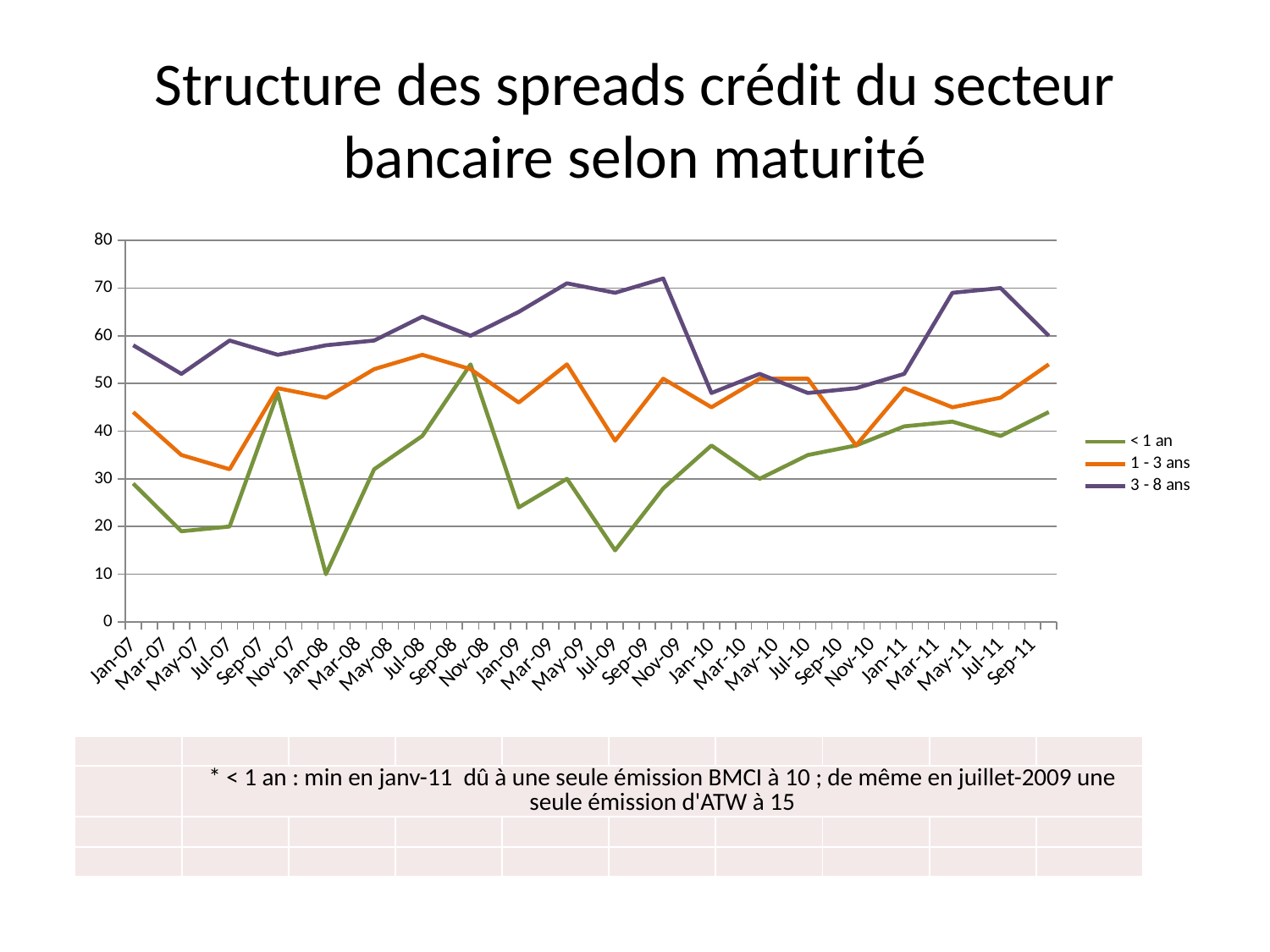
Is the value for "3 - 8 ans" at Nov-09 greater or less than 60? greater What colour is the line for the "< 1 an" series? green At Jan-07, which series has the larger value, "3 - 8 ans" or "< 1 an"? 3 - 8 ans At which date does the "< 1 an" series reach its lowest value? Jan-08 Is the value for "3 - 8 ans" at Jan-07 greater or less than 50? greater How many series does the legend list? 3 Is the value for "< 1 an" at Jul-09 greater or less than 20? less Which series has the highest values over most of the period? 3 - 8 ans What are the three series listed in the legend? < 1 an, 1 - 3 ans, 3 - 8 ans What kind of chart is shown on the slide? line chart